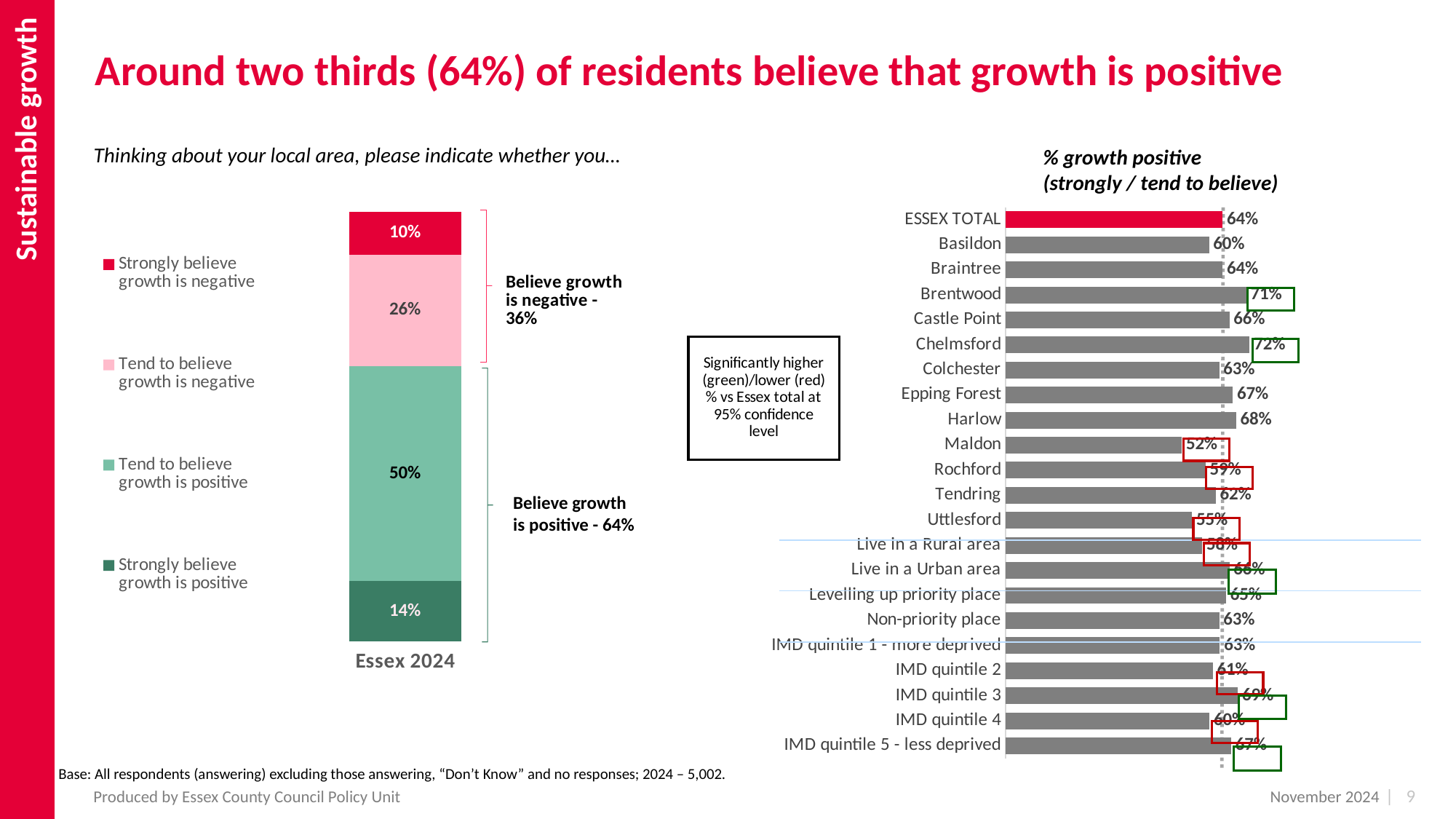
In the '% growth positive' chart on the right, what is the difference between Brentwood and Basildon? 11% In the stacked bar chart on the left, what is the combined share of residents who believe growth is negative? 36% In the '% growth positive' chart on the right, what is the value for Chelmsford? 72% In the stacked bar chart on the left, what percentage of residents tend to believe growth is positive? 50% In the '% growth positive' chart on the right, which area has the highest value? Chelmsford In the stacked bar chart on the left, what percentage of residents strongly believe growth is negative? 10% In the stacked bar chart on the left, how many series does the legend list? 4 In the '% growth positive' chart on the right, how many bars are plotted? 22 In the '% growth positive' chart on the right, which is larger, Harlow or Uttlesford? Harlow In the stacked bar chart on the left, what is the difference between the 'Tend to believe growth is positive' and 'Strongly believe growth is positive' segments? 36% In the '% growth positive' chart on the right, which area has the lowest value? Maldon What type of chart is the '% growth positive' chart on the right? Bar chart